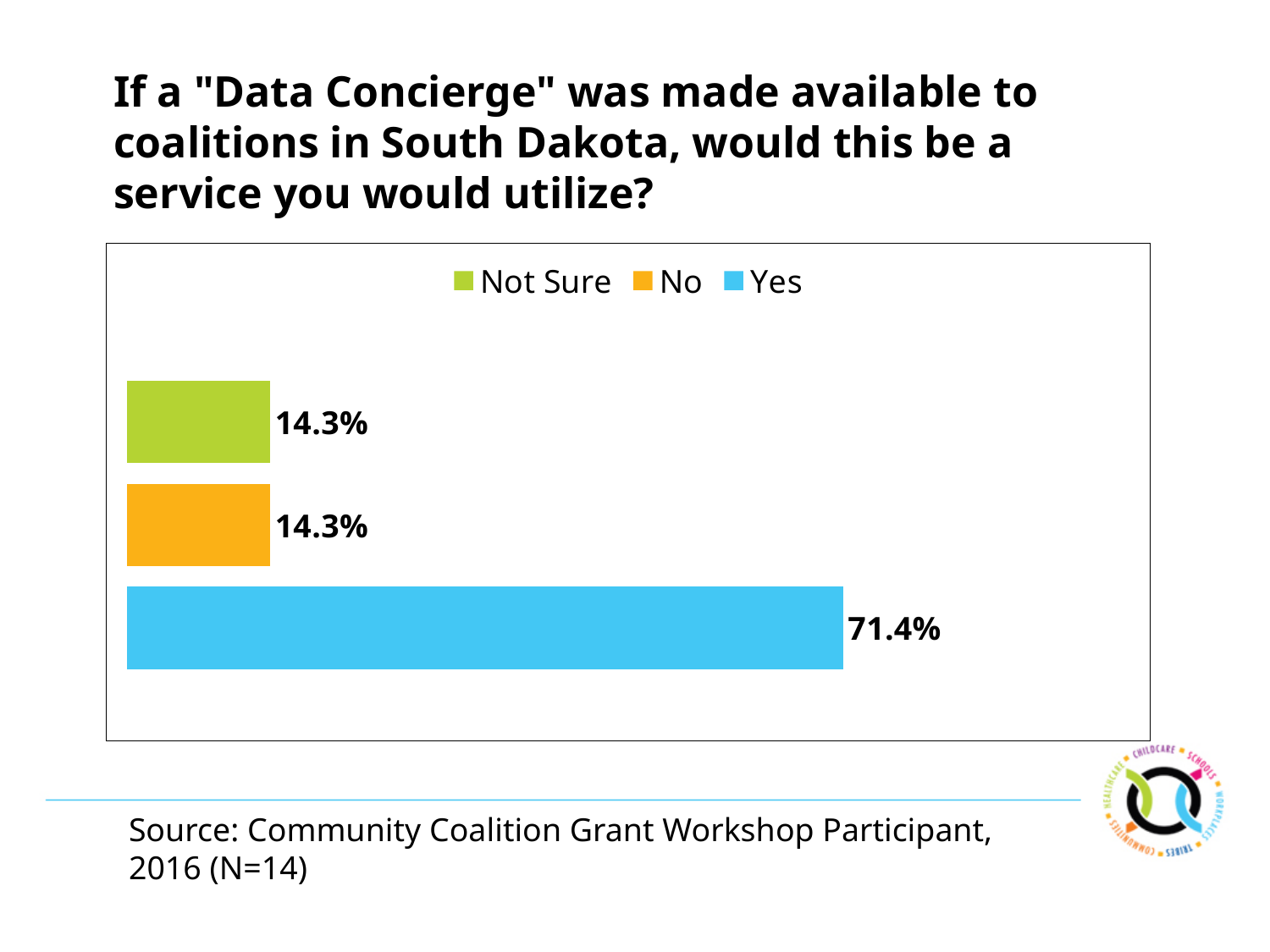
Do the No and Not Sure responses have the same percentage? Yes What is the sample size (N) given in the source note? 14 How many bars are plotted in the chart? 3 What colour is the bar for Yes? Blue What percentage of respondents answered No? 14.3% Which is larger, the percentage for Yes or the percentage for Not Sure? Yes How many series does the legend list? 3 What is the difference in percentage points between Yes and No? 57.1 What kind of chart is shown on the slide? Bar chart What percentage of respondents answered Not Sure? 14.3% Which response has the highest percentage? Yes What percentage of respondents answered Yes? 71.4%